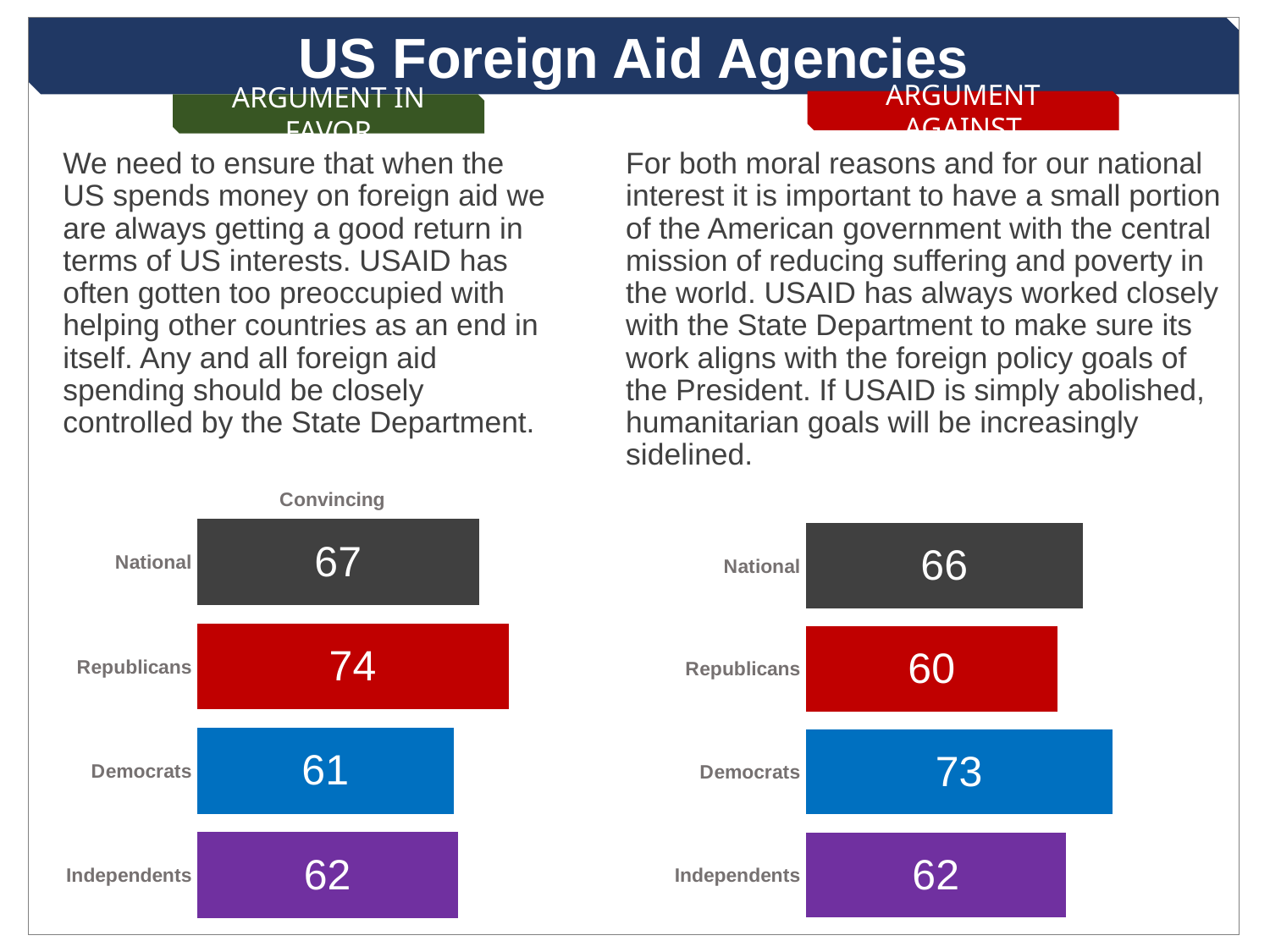
In the left chart (Argument in Favor), what is the difference between the Republicans and Democrats values? 13 In the right chart (Argument Against), what is the difference between the Democrats and Republicans values? 13 In the left chart (Argument in Favor), what is the value for Republicans? 74 What label appears above the left chart (Argument in Favor)? Convincing In the left chart (Argument in Favor), what is the National value? 67 In the right chart (Argument Against), which group has the lowest value? Republicans In the right chart (Argument Against), what is the value for Democrats? 73 What type of chart is used on the right side of the slide (Argument Against)? Bar chart What is the value for Independents in the right chart (Argument Against)? 62 In the right chart (Argument Against), which is larger, the National value or the Independents value? National How many bars are in the left chart (Argument in Favor)? 4 In the left chart (Argument in Favor), which group has the highest value? Republicans